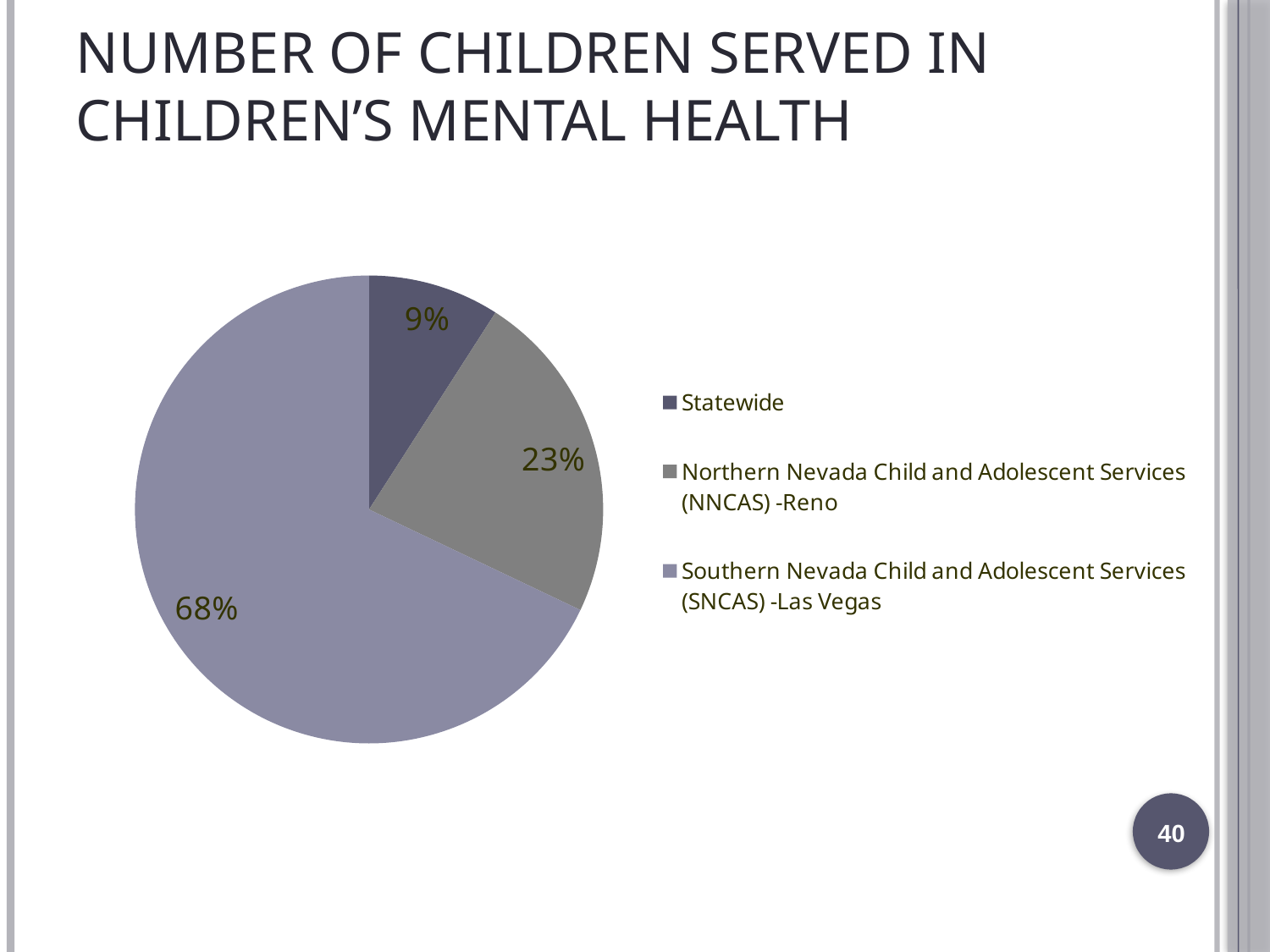
How many slices does the pie chart have? 3 What is the title of the slide containing the pie chart? NUMBER OF CHILDREN SERVED IN CHILDREN'S MENTAL HEALTH What share of the pie does Southern Nevada Child and Adolescent Services (SNCAS) -Las Vegas represent? 68% What is the difference in percentage points between the SNCAS -Las Vegas slice and the NNCAS -Reno slice? 45 Which category has the smallest slice of the pie? Statewide What share of the pie does Northern Nevada Child and Adolescent Services (NNCAS) -Reno represent? 23% What share of the pie does Statewide represent? 9% Which is larger, the NNCAS -Reno slice or the Statewide slice? NNCAS -Reno What is the difference in percentage points between the NNCAS -Reno slice and the Statewide slice? 14 Which category has the largest slice of the pie? Southern Nevada Child and Adolescent Services (SNCAS) -Las Vegas What kind of chart is shown on the slide? pie chart How many entries does the legend list? 3